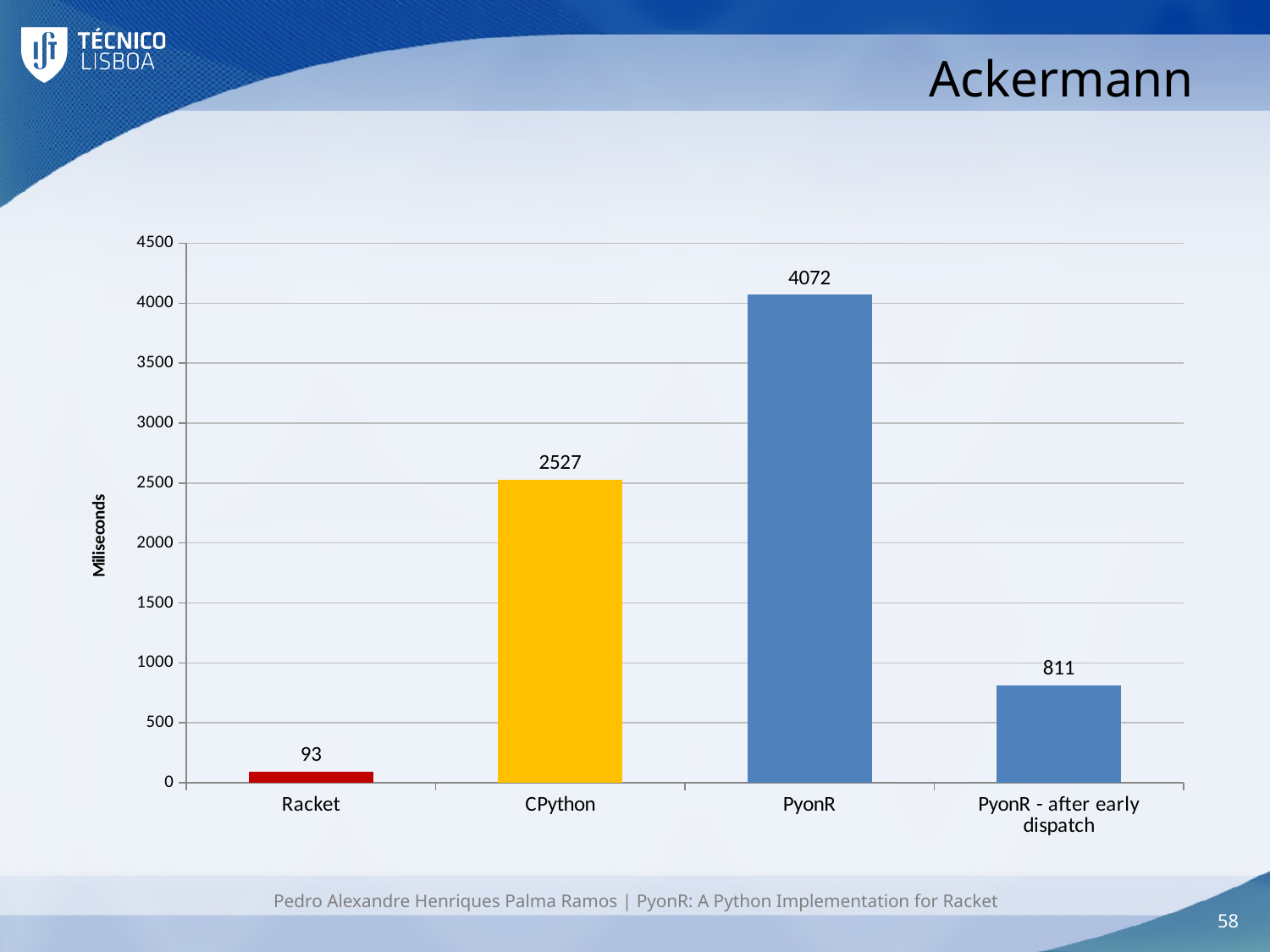
What is the value for PyonR - after early dispatch? 811 What is the label of the y axis? Miliseconds What is the value for Racket? 93 Which category has the highest value? PyonR What is the value for CPython? 2527 Which is larger, the value for CPython or the value for PyonR - after early dispatch? CPython Is the value for CPython greater or less than 2000? greater What kind of chart is shown on the slide? bar chart How many categories are shown on the x axis? 4 What is the difference between the values for PyonR and PyonR - after early dispatch? 3261 What is the value for PyonR? 4072 Which category has the lowest value? Racket